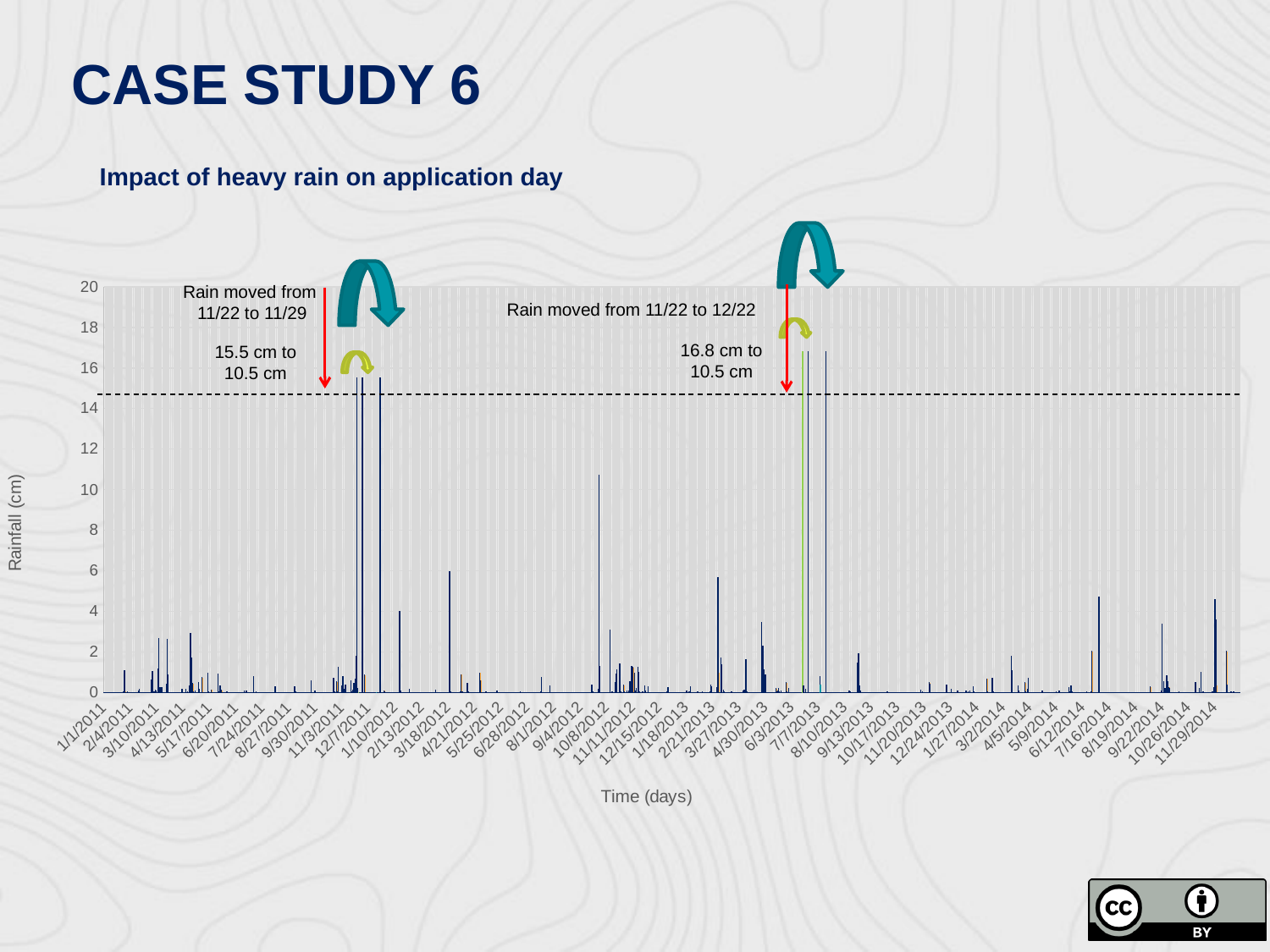
In the right annotation, the rainfall changed from what value to 10.5 cm? 16.8 cm What kind of chart is shown on the slide? bar chart What is the label of the horizontal axis of the chart? Time (days) Is the rainfall value of the tall bar near 2/21/2013 greater or less than 8? less According to the annotation on the left of the chart, the rain was moved from 11/22 to which date? 11/29 According to the annotation on the right of the chart, the rain was moved from 11/22 to which date? 12/22 Is the rainfall value of the tall bar near 4/21/2012 greater or less than 4? greater In the left annotation, the rainfall changed from 15.5 cm to what value? 10.5 cm What is the maximum value shown on the vertical axis of the chart? 20 Is the rainfall value of the tall bar near 10/8/2012 greater or less than 10? greater What is the label of the vertical axis of the chart? Rainfall (cm)